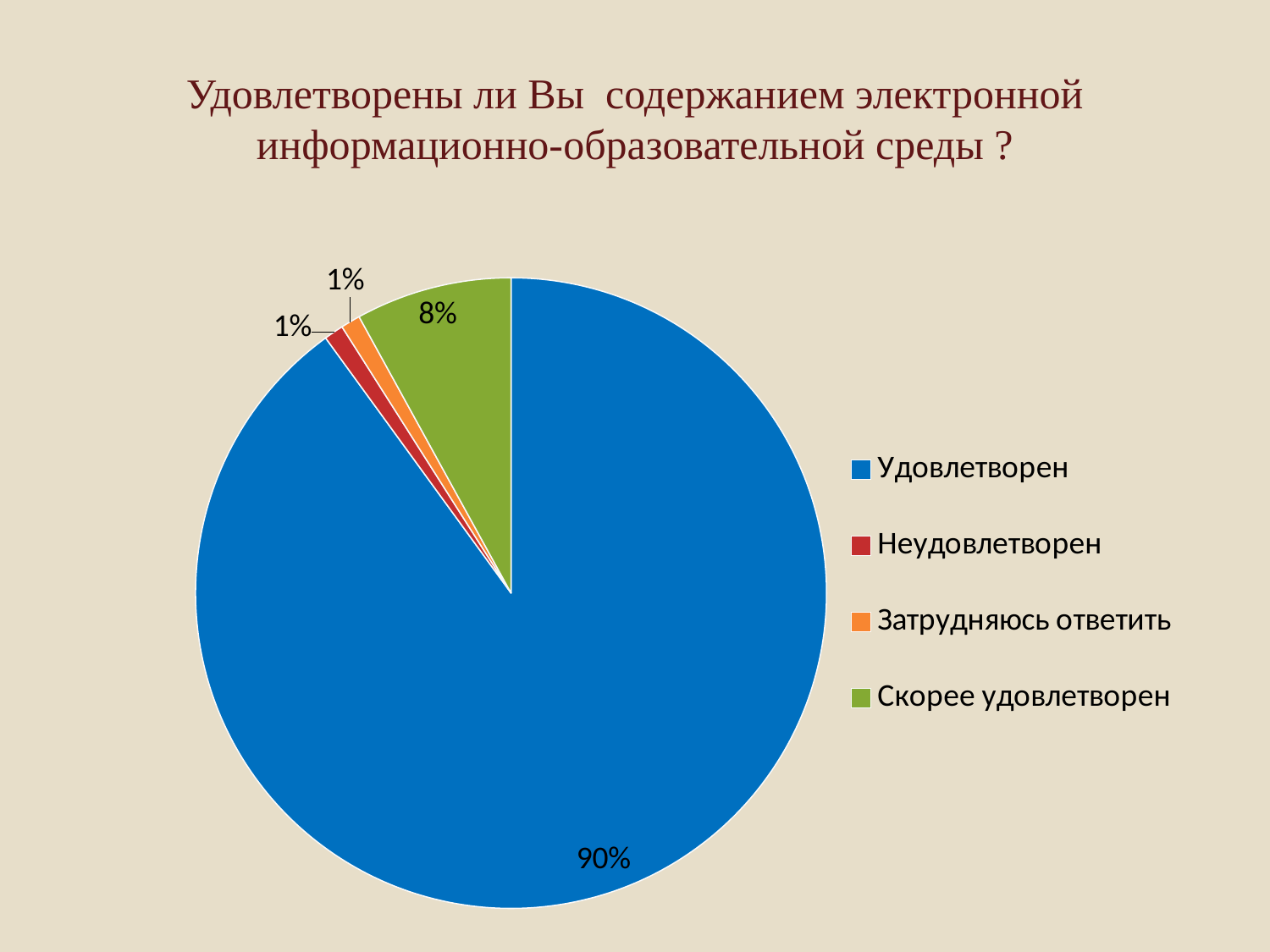
What colour is the slice for "Скорее удовлетворен"? green What is the title of the chart? Удовлетворены ли Вы содержанием электронной информационно-образовательной среды ? Which category has the largest slice of the pie? Удовлетворен What is the combined share of "Удовлетворен" and "Скорее удовлетворен"? 98% How many categories does the legend list? 4 Which is larger, the share for "Скорее удовлетворен" or the share for "Неудовлетворен"? Скорее удовлетворен What share of the pie does "Скорее удовлетворен" have? 8% What share of the pie does "Удовлетворен" have? 90% What kind of chart is shown on the slide? pie chart What share of the pie does "Затрудняюсь ответить" have? 1% What is the difference between the shares of "Удовлетворен" and "Скорее удовлетворен"? 82%